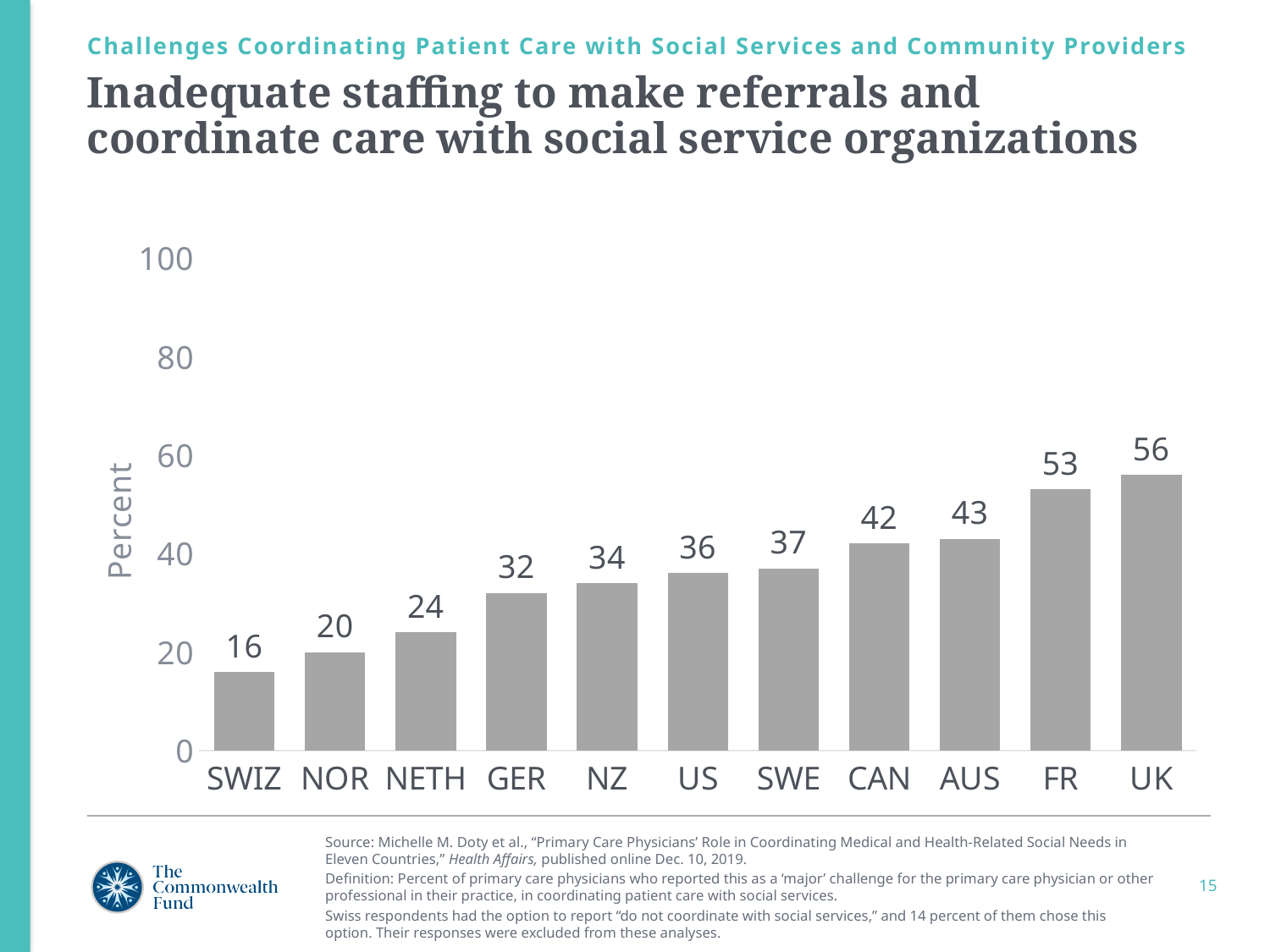
Which country has the lowest value? SWIZ Which has a larger value, NETH or SWE? SWE Is the value for AUS greater or less than 40? greater What is the label of the vertical axis? Percent What is the difference between the values for UK and SWIZ? 40 What is the value for the US? 36 Which country has the highest value? UK What is the difference between the values for FR and CAN? 11 What is the value for SWIZ? 16 How many countries are shown on the chart? 11 What kind of chart is shown on the slide? bar chart What is the value for GER? 32